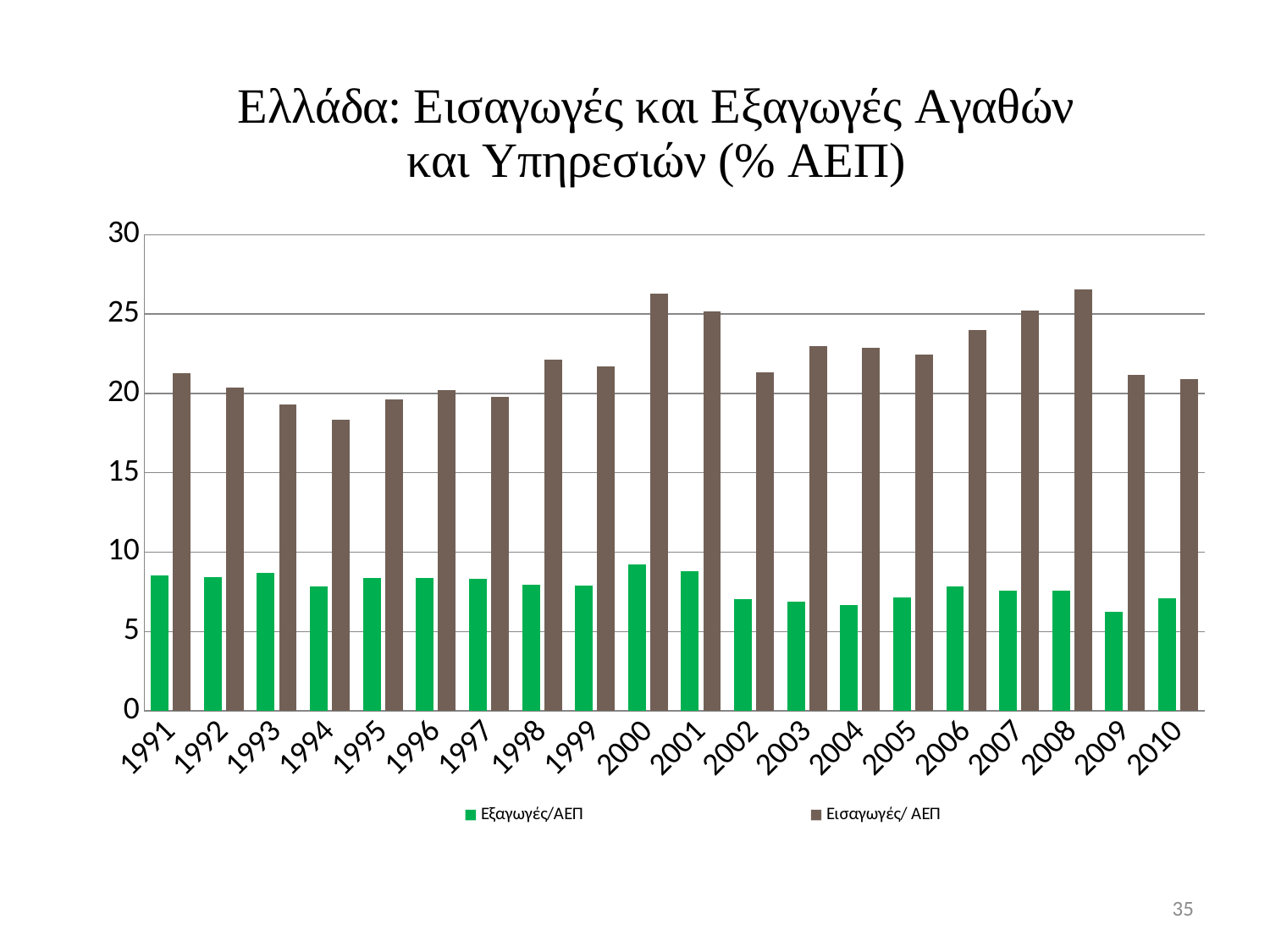
What colour are the bars for Εξαγωγές/ΑΕΠ? green Is the value for Εισαγωγές/ ΑΕΠ in 2008 greater or less than 25? greater Which year has the lowest value for Εισαγωγές/ ΑΕΠ? 1994 Which year has the lowest value for Εξαγωγές/ΑΕΠ? 2009 How many years are shown on the x axis? 20 How many series does the legend list? 2 Which is larger, Εξαγωγές/ΑΕΠ in 1991 or in 2002? 1991 Which is larger, Εισαγωγές/ ΑΕΠ in 2007 or in 2009? 2007 Which year has the highest value for Εξαγωγές/ΑΕΠ? 2000 Is the value for Εισαγωγές/ ΑΕΠ in 1994 greater or less than 20? less Is the value for Εξαγωγές/ΑΕΠ in 2000 greater or less than 10? less What kind of chart is shown on the slide? bar chart